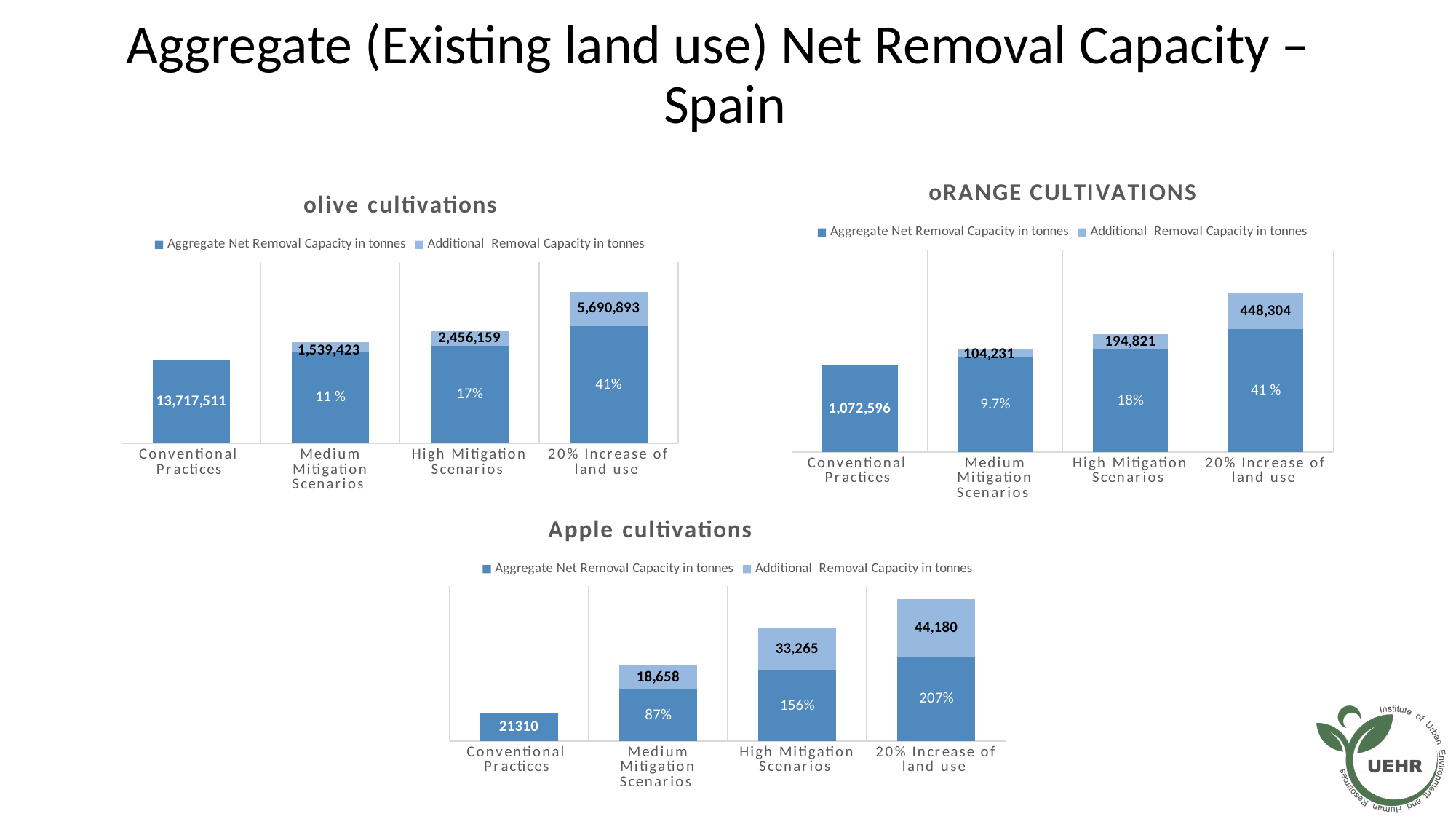
How many categories are shown on the x axis of the olive cultivations chart? 4 In the olive cultivations chart, what percentage is printed on the High Mitigation Scenarios bar? 17% How many series does the legend of the oRANGE CULTIVATIONS chart list? 2 In the olive cultivations chart, what value is printed on the Conventional Practices bar? 13,717,511 In the oRANGE CULTIVATIONS chart, what value is printed on the Additional Removal Capacity segment for High Mitigation Scenarios? 194,821 In the oRANGE CULTIVATIONS chart, what percentage is printed on the Medium Mitigation Scenarios bar? 9.7% In the Apple cultivations chart, which category has the tallest bar? 20% Increase of land use In the Apple cultivations chart, which category has the shortest bar? Conventional Practices In the olive cultivations chart, what value is printed on the Additional Removal Capacity segment for 20% Increase of land use? 5,690,893 In the Apple cultivations chart, what value is printed on the Conventional Practices bar? 21310 In the oRANGE CULTIVATIONS chart, what value is printed on the Conventional Practices bar? 1,072,596 In the Apple cultivations chart, what percentage is printed on the 20% Increase of land use bar? 207%